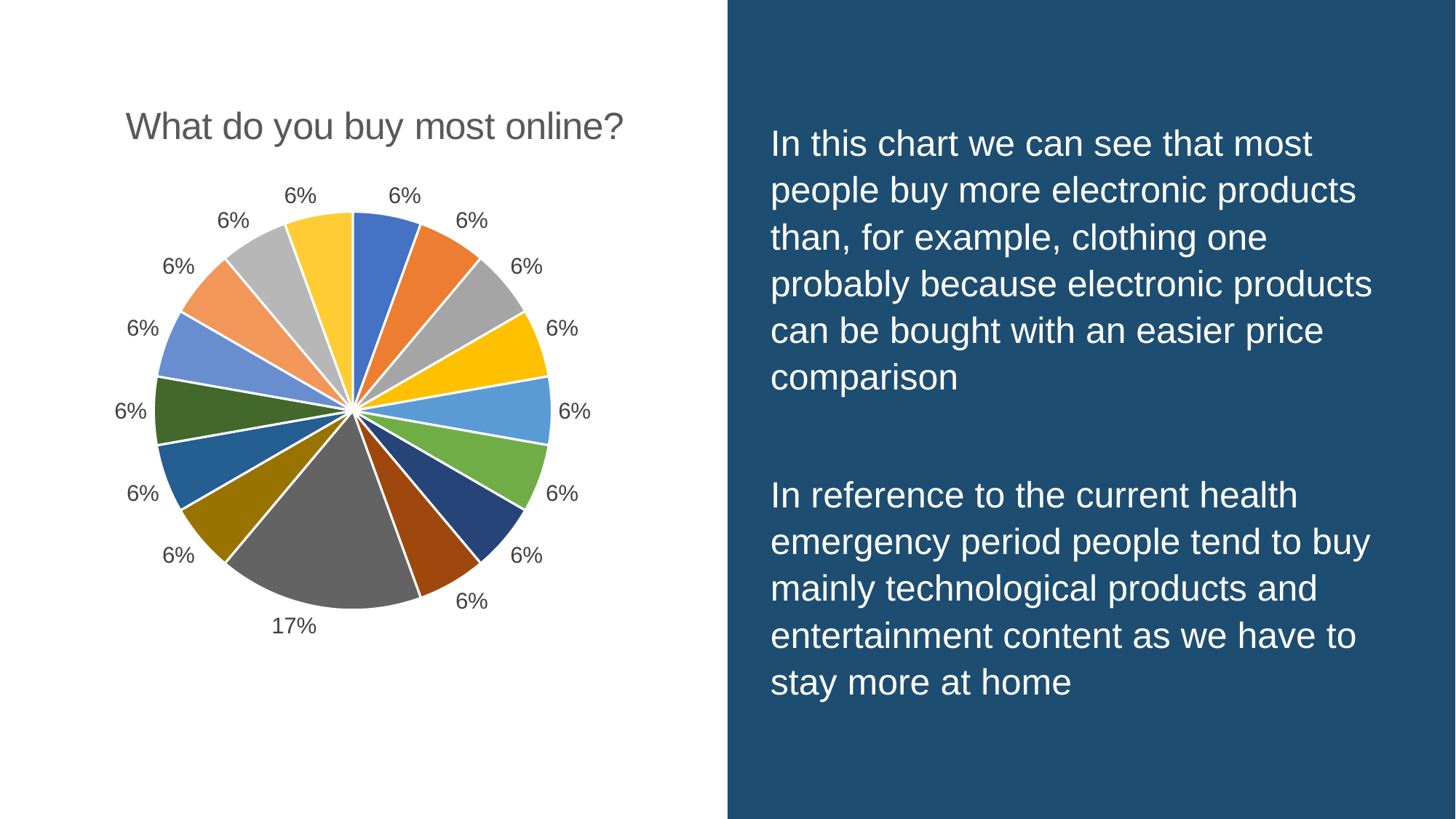
What colour is the largest slice of the pie chart? dark gray Is the dark gray slice larger or smaller than the blue slice at the top of the pie? larger How many slices in the pie chart are labelled 6%? 15 What is the title of the chart? What do you buy most online? What kind of chart is shown on the slide? pie chart What share of the pie does the dark gray slice represent? 17% How many slices does the pie chart have? 16 What is the largest share shown in the pie chart? 17% What is the difference in percentage points between the largest slice (17%) and one of the 6% slices? 11 What is the smallest share shown in the pie chart? 6% Is the largest slice of the pie chart greater or less than 15%? greater